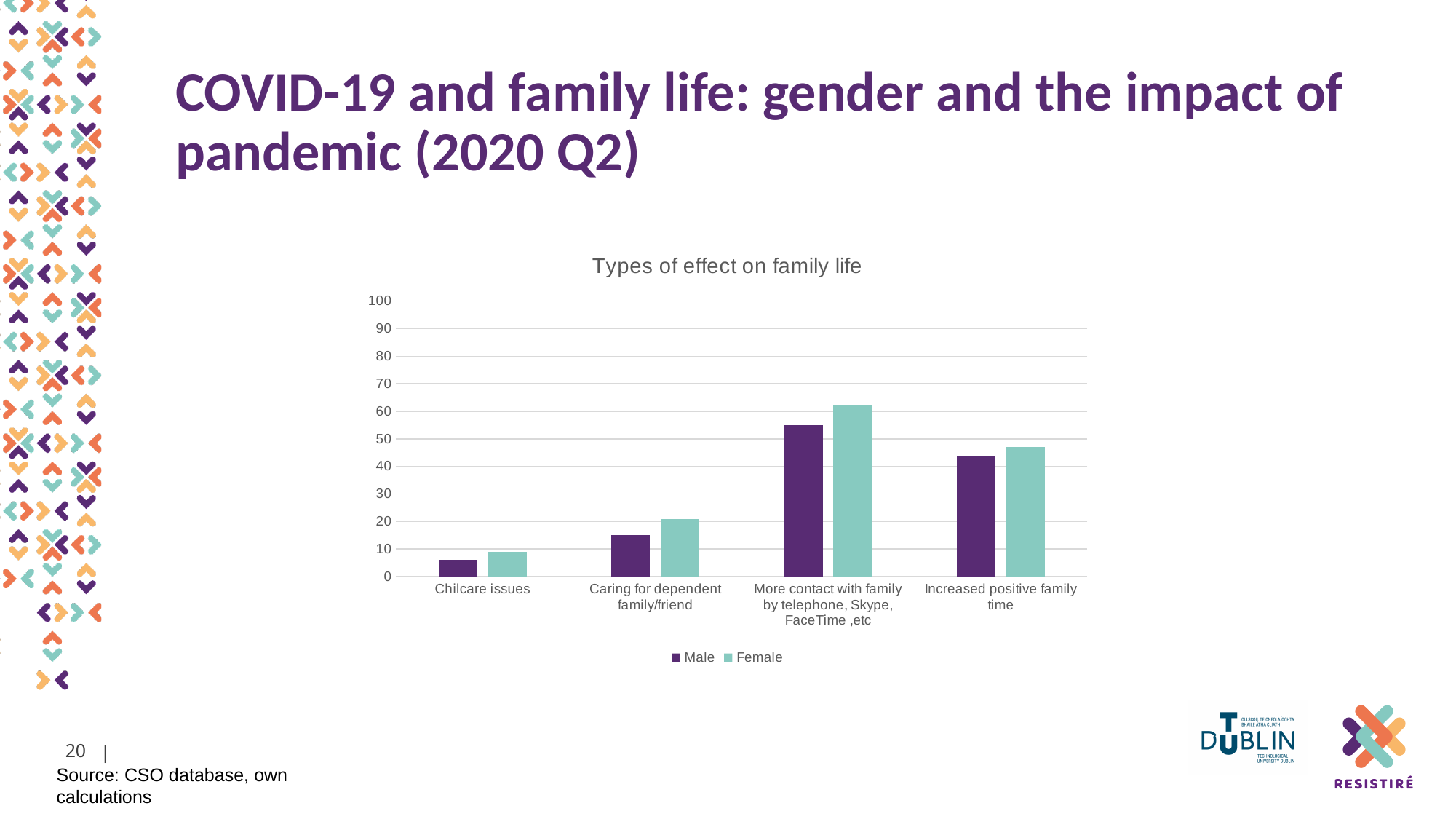
Which category has the lowest value for Male? Chilcare issues For 'Caring for dependent family/friend', which is larger, Male or Female? Female Is the Male value for 'Caring for dependent family/friend' greater or less than 20? less What is the title of the chart? Types of effect on family life Is the Male value for 'More contact with family by telephone, Skype, FaceTime ,etc' greater or less than 50? greater Is the Male value for 'Increased positive family time' greater or less than 50? less What type of chart is shown on the slide? bar chart Which category has the highest value for Female? More contact with family by telephone, Skype, FaceTime ,etc How many categories are shown on the x axis? 4 For 'More contact with family by telephone, Skype, FaceTime ,etc', which is larger, Male or Female? Female How many series does the legend list? 2